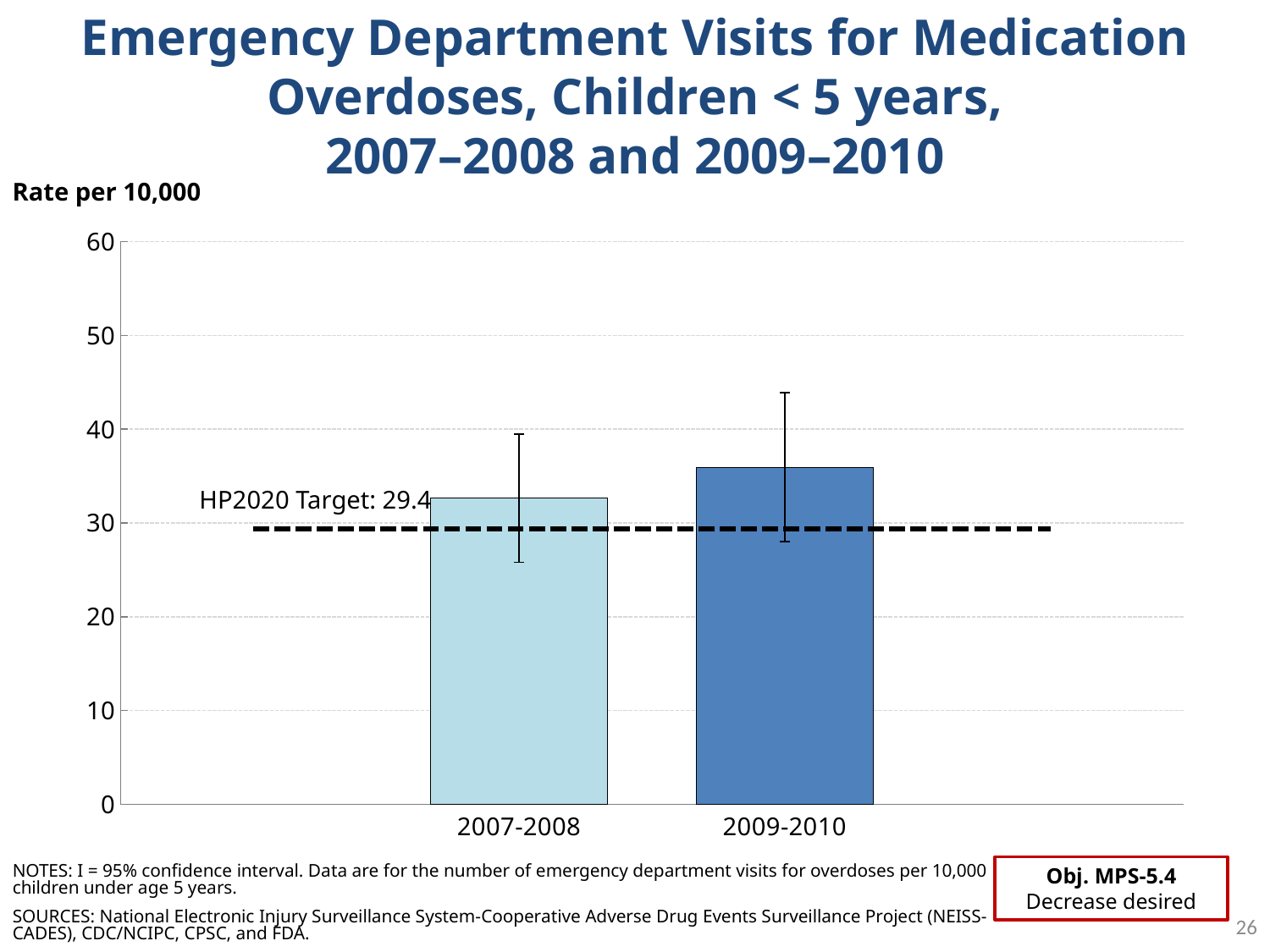
Is the rate for 2009-2010 larger or smaller than the rate for 2007-2008? larger Does the rate rise or fall from 2007-2008 to 2009-2010? rise Which time period has the higher rate of emergency department visits for medication overdoses? 2009-2010 How many time periods (bars) are plotted in the chart? 2 What is the highest value shown on the y axis? 60 Is the value for 2007-2008 greater or less than 40? less What is the HP2020 Target value shown by the dashed line? 29.4 Which time period has the lower rate of emergency department visits for medication overdoses? 2007-2008 What unit is the y axis measured in, according to the label above the chart? Rate per 10,000 Is the value for 2007-2008 greater or less than 30? greater What kind of chart is shown on the slide? bar chart Is the value for 2009-2010 greater or less than 40? less